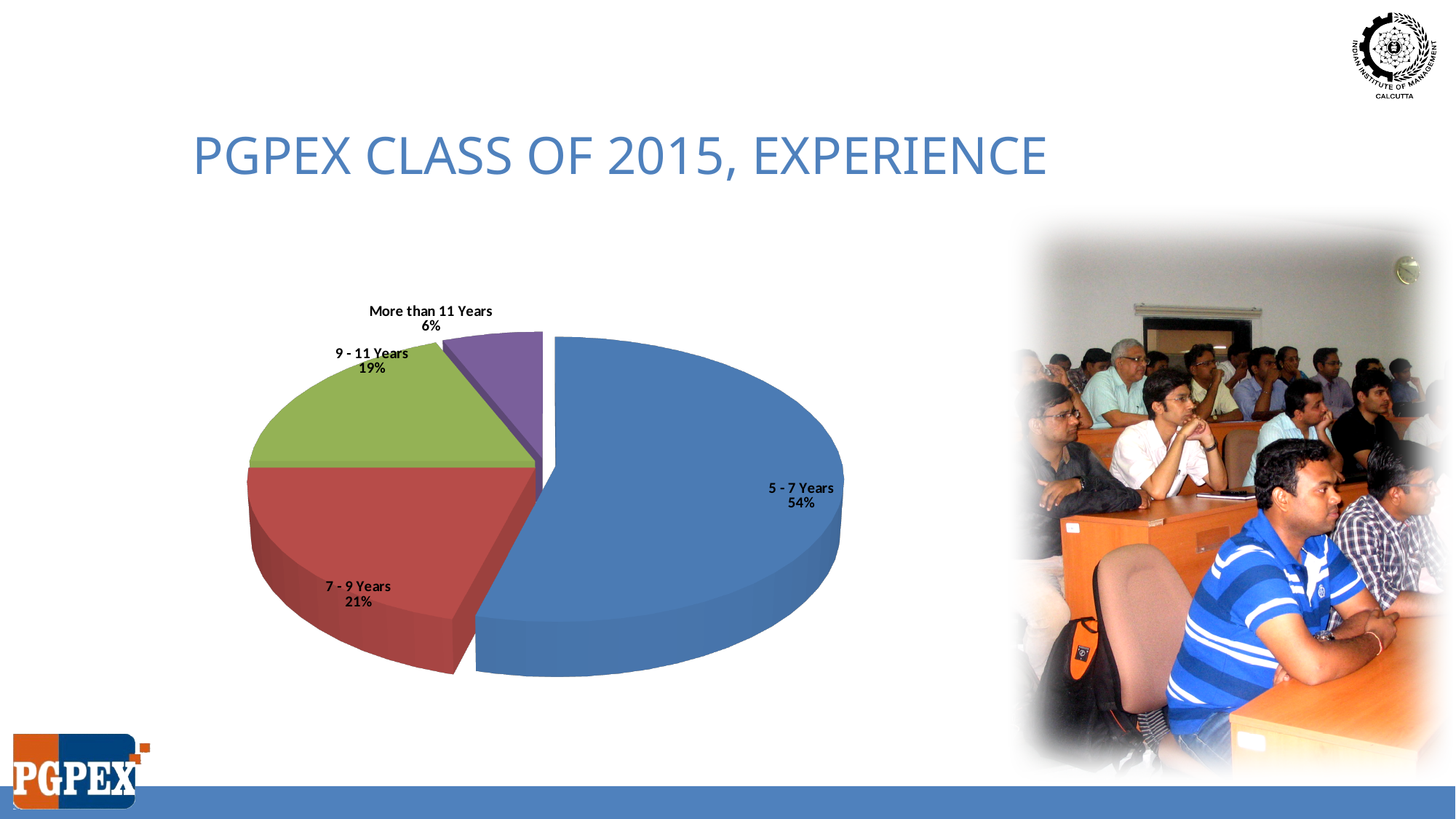
What share of the class has 7 - 9 years of experience? 21% What is the combined share of the 9 - 11 Years and More than 11 Years slices? 25% What colour is the 5 - 7 Years slice? blue Which experience category has the smallest share? More than 11 Years What is the difference in percentage points between the 5 - 7 Years and 7 - 9 Years slices? 33 Which is larger, the 7 - 9 Years slice or the 9 - 11 Years slice? 7 - 9 Years Which experience category has the largest share? 5 - 7 Years What share of the class has 5 - 7 years of experience? 54% What share of the class has 9 - 11 years of experience? 19% What share of the class has more than 11 years of experience? 6% How many experience categories does the pie chart show? 4 What kind of chart is shown on the slide? pie chart